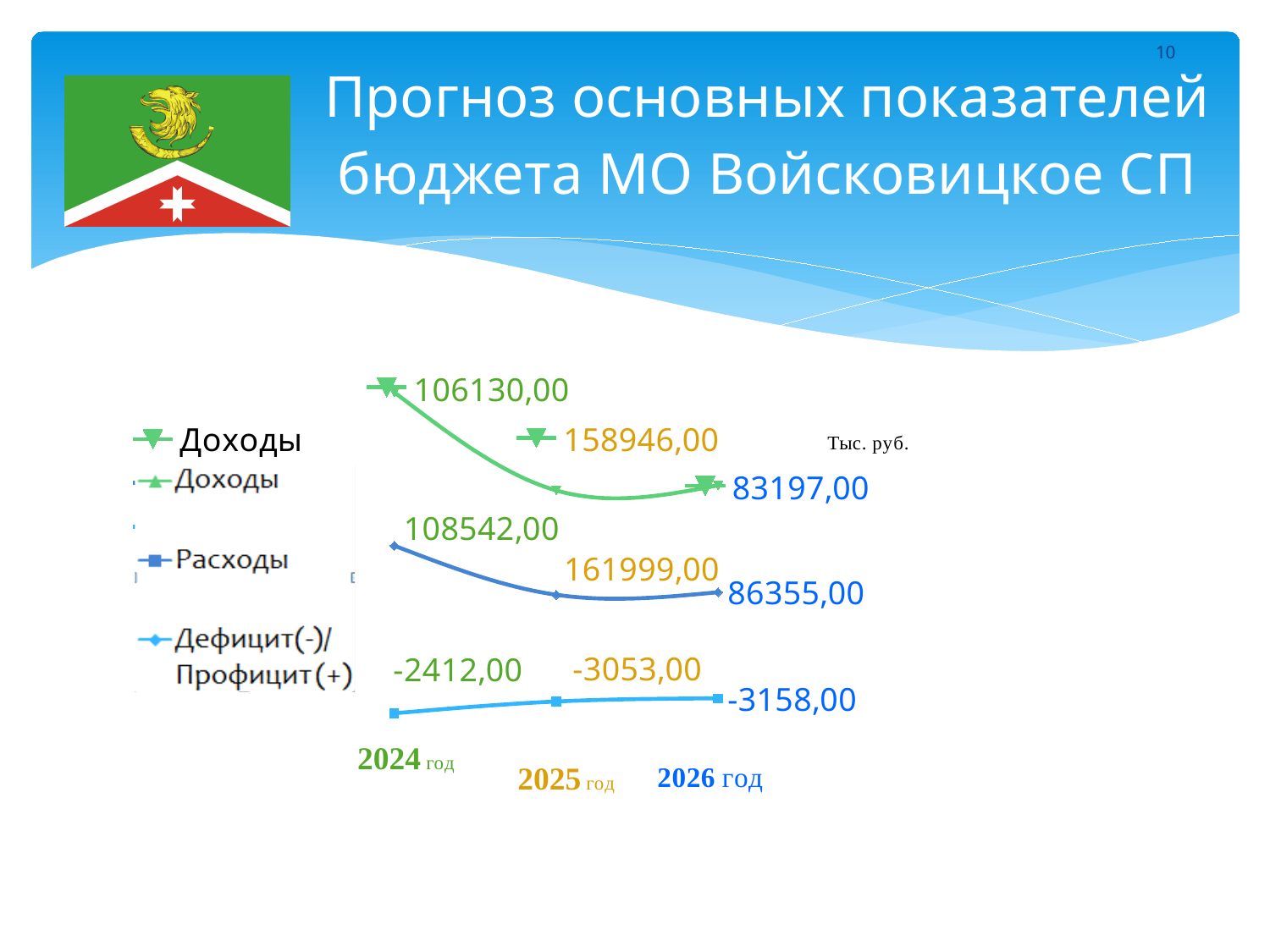
How many years are shown on the x axis of the chart? 3 What is the difference between Расходы and Доходы in 2026 год? 3158,00 In which year is Расходы highest according to the data labels? 2025 год How many series does the chart legend list? 3 Which is larger in 2025 год, Доходы or Расходы? Расходы What kind of chart is shown on the slide? line chart What is the value of Дефицит(-)/Профицит(+) for 2026 год? -3158,00 What is the difference between Расходы and Доходы in 2024 год? 2412,00 What is the value of Доходы for 2026 год? 83197,00 In which year is Доходы lowest according to the data labels? 2026 год What is the value of Доходы for 2024 год? 106130,00 What is the value of Расходы for 2025 год? 161999,00